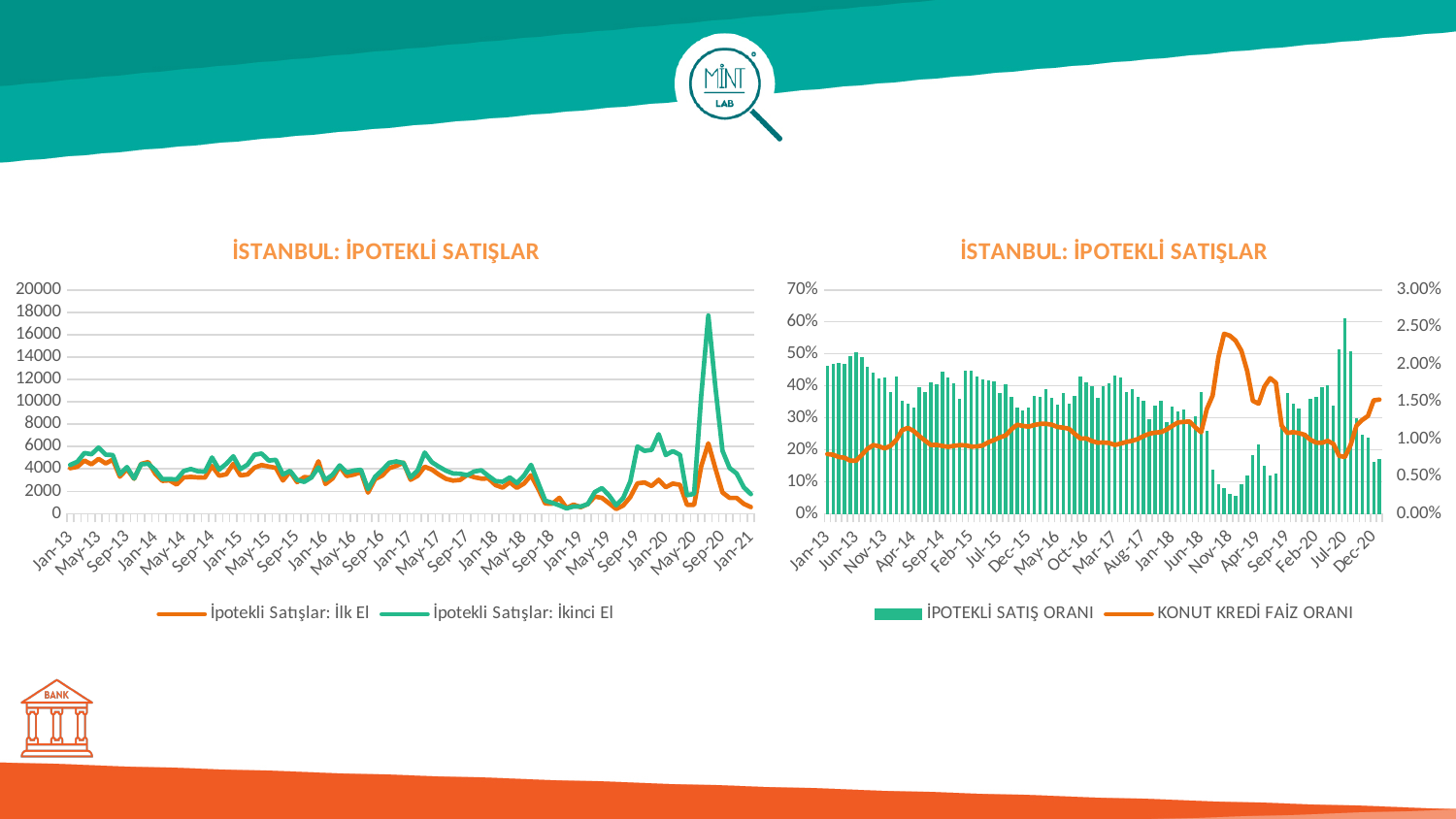
In the right chart, is the peak value of KONUT KREDİ FAİZ ORANI greater or less than 2.00%? greater In the right chart, is the value of KONUT KREDİ FAİZ ORANI at Jan-13 greater or less than 1.00%? less What are the two legend entries of the left chart? İpotekli Satışlar: İlk El; İpotekli Satışlar: İkinci El In the left chart, is the value for İpotekli Satışlar: İlk El at Jan-13 greater or less than 2000? greater In the right chart, which series is drawn as bars? İPOTEKLİ SATIŞ ORANI How many series does the legend of the right chart list? 2 In the left chart, which series reaches the highest value? İpotekli Satışlar: İkinci El How many series does the legend of the left chart list? 2 What kind of chart is the left chart on the slide? Line chart